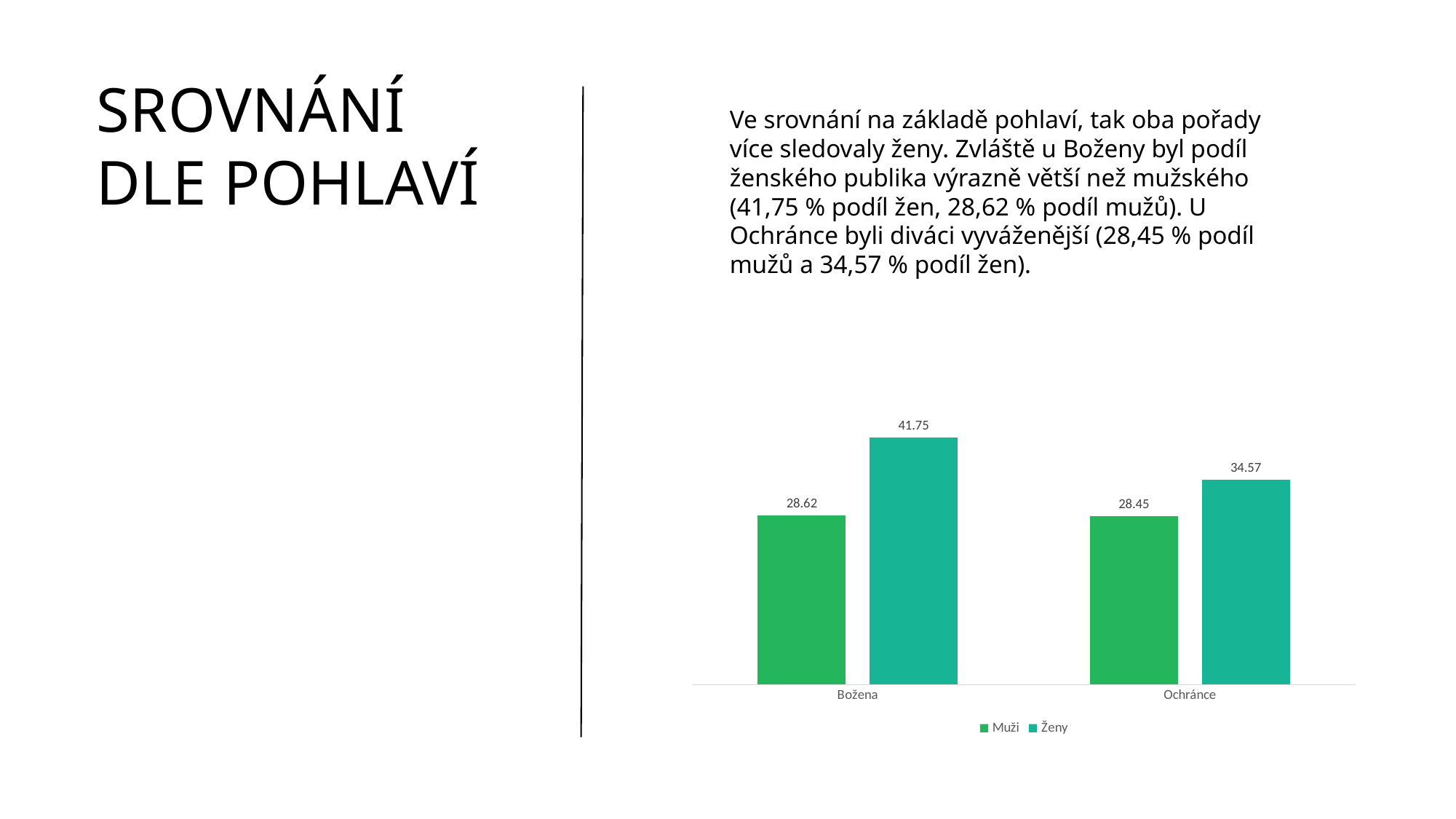
What is the difference between the Ženy and Muži values for Ochránce? 6.12 Which is larger: the Ženy value for Božena or the Ženy value for Ochránce? Ženy for Božena What is the difference between the Ženy and Muži values for Božena? 13.13 What are the two series named in the legend? Muži and Ženy How many series does the legend list? 2 What is the value for Ženy in the Ochránce category? 34.57 How many categories are shown on the x axis? 2 What is the value for Muži in the Božena category? 28.62 What is the value for Muži in the Ochránce category? 28.45 Which bar has the highest value on the chart? Ženy for Božena What is the value for Ženy in the Božena category? 41.75 What kind of chart is shown on the slide? Bar chart